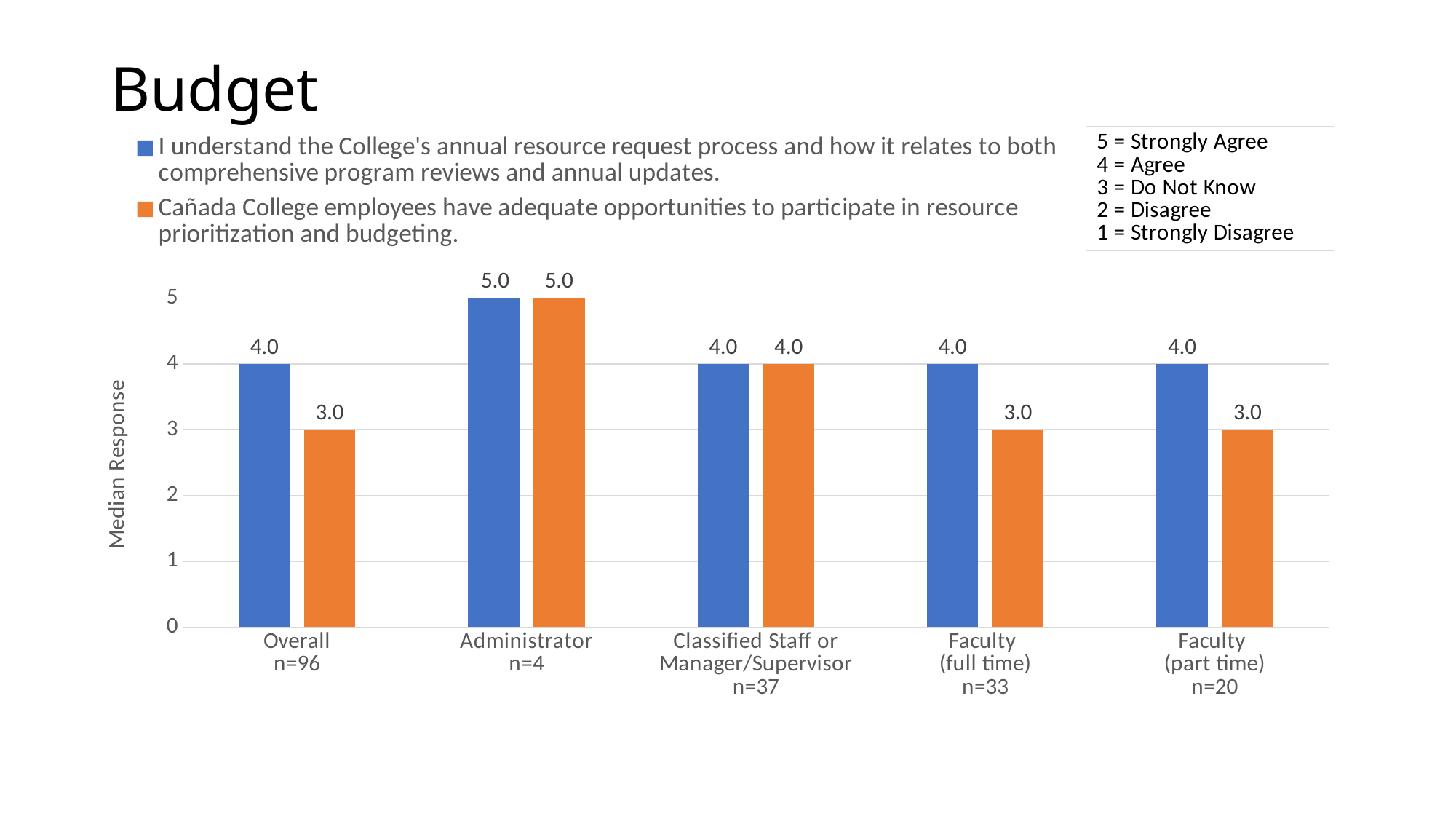
What is the sample size (n) for the Classified Staff or Manager/Supervisor group? n=37 Which group has the highest median response for the statement 'I understand the College's annual resource request process and how it relates to both comprehensive program reviews and annual updates.'? Administrator What is the difference between the two median responses for Faculty (full time)? 1.0 What is the median response for Administrator on the statement 'Cañada College employees have adequate opportunities to participate in resource prioritization and budgeting.'? 5.0 How many series does the legend list? 2 What is the median response for Classified Staff or Manager/Supervisor on the statement 'Cañada College employees have adequate opportunities to participate in resource prioritization and budgeting.'? 4.0 What kind of chart is shown on the slide? Bar chart What is the median response for Overall on the statement 'I understand the College's annual resource request process and how it relates to both comprehensive program reviews and annual updates.'? 4.0 What is the label of the vertical axis? Median Response What is the median response for Faculty (part time) on the statement 'Cañada College employees have adequate opportunities to participate in resource prioritization and budgeting.'? 3.0 How many groups are shown on the x axis of the chart? 5 For Overall, which statement has the larger median response: 'I understand the College's annual resource request process...' or 'Cañada College employees have adequate opportunities...'? I understand the College's annual resource request process and how it relates to both comprehensive program reviews and annual updates.